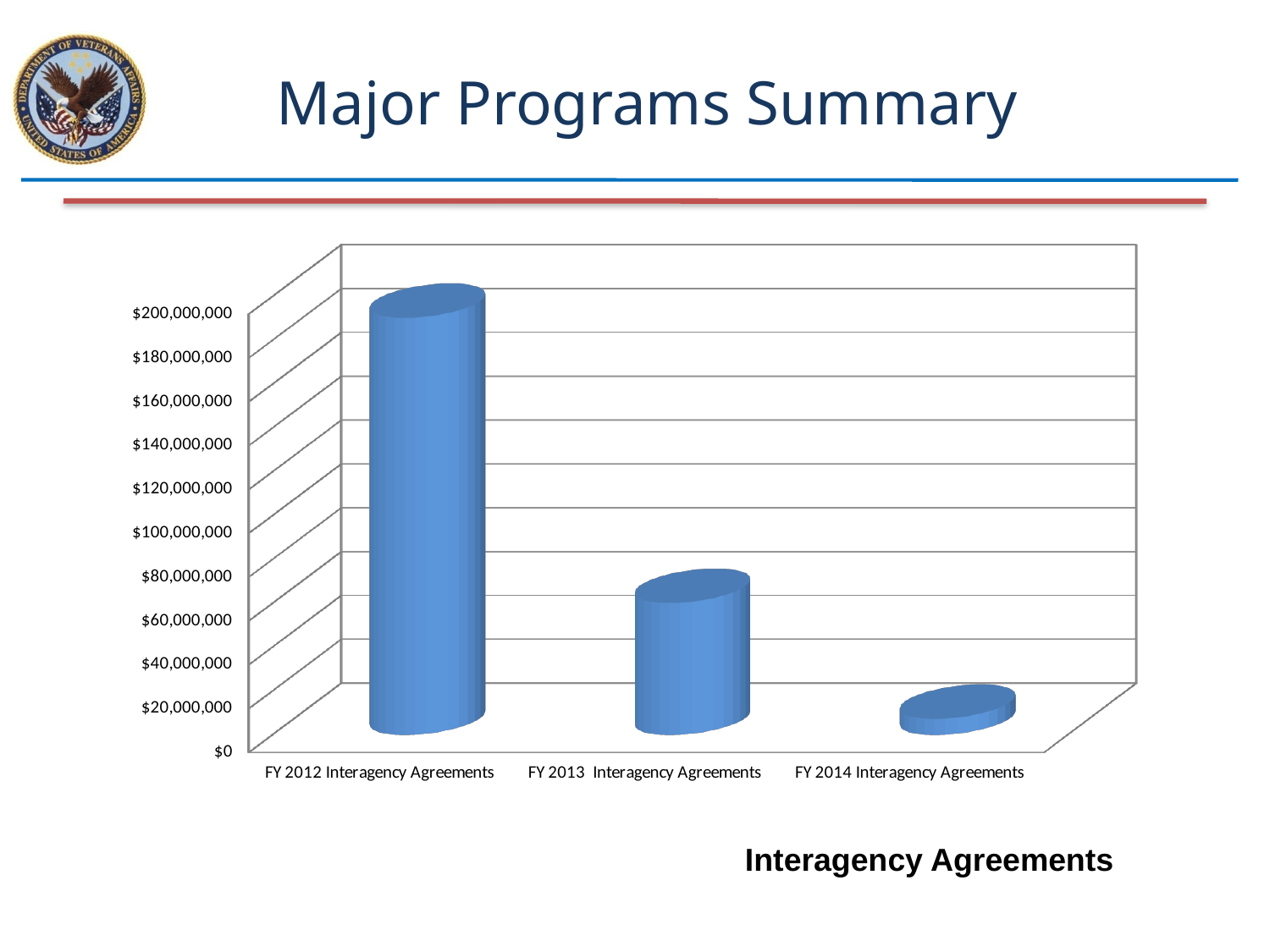
Which category has the highest value? FY 2012 Interagency Agreements Which category has the lowest value? FY 2014 Interagency Agreements What kind of chart is shown on the slide? bar chart What colour are the bars in the chart? blue Is the value for FY 2013 Interagency Agreements greater or less than $100,000,000? less Which is larger, the value for FY 2013 Interagency Agreements or FY 2014 Interagency Agreements? FY 2013 Interagency Agreements How many categories are plotted in the chart? 3 What is the title shown below the chart? Interagency Agreements Is the value for FY 2012 Interagency Agreements greater or less than $140,000,000? greater Which is larger, the value for FY 2012 Interagency Agreements or FY 2013 Interagency Agreements? FY 2012 Interagency Agreements Do the values rise or fall from FY 2012 to FY 2014 along the x axis? fall Is the value for FY 2014 Interagency Agreements greater or less than $40,000,000? less